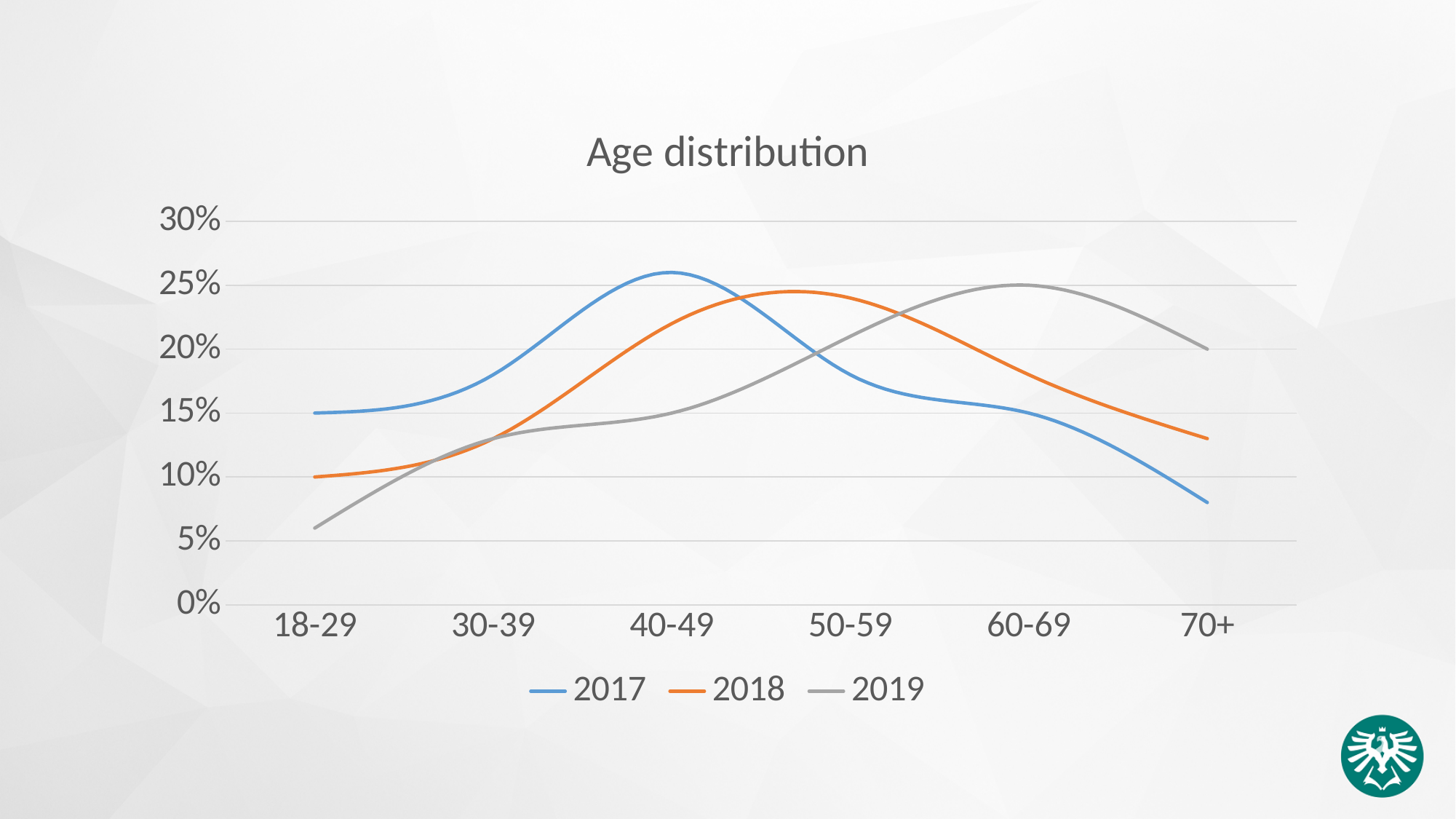
Does the 2017 line rise or fall from the 40-49 group to the 70+ group? fall What is the value for 2019 in the 60-69 age group? 25% Is the value for 2017 in the 40-49 age group greater or less than 25%? greater What kind of chart is shown on the slide? line chart In the 70+ age group, which series has the larger value, 2017 or 2019? 2019 What is the value for 2017 in the 18-29 age group? 15% How many age groups are shown on the x axis? 6 How many series does the legend list? 3 What is the value for 2018 in the 18-29 age group? 10% In which age group does the 2017 line reach its highest value? 40-49 Is the value for 2017 in the 70+ age group greater or less than 10%? less In which age group does the 2019 line reach its lowest value? 18-29